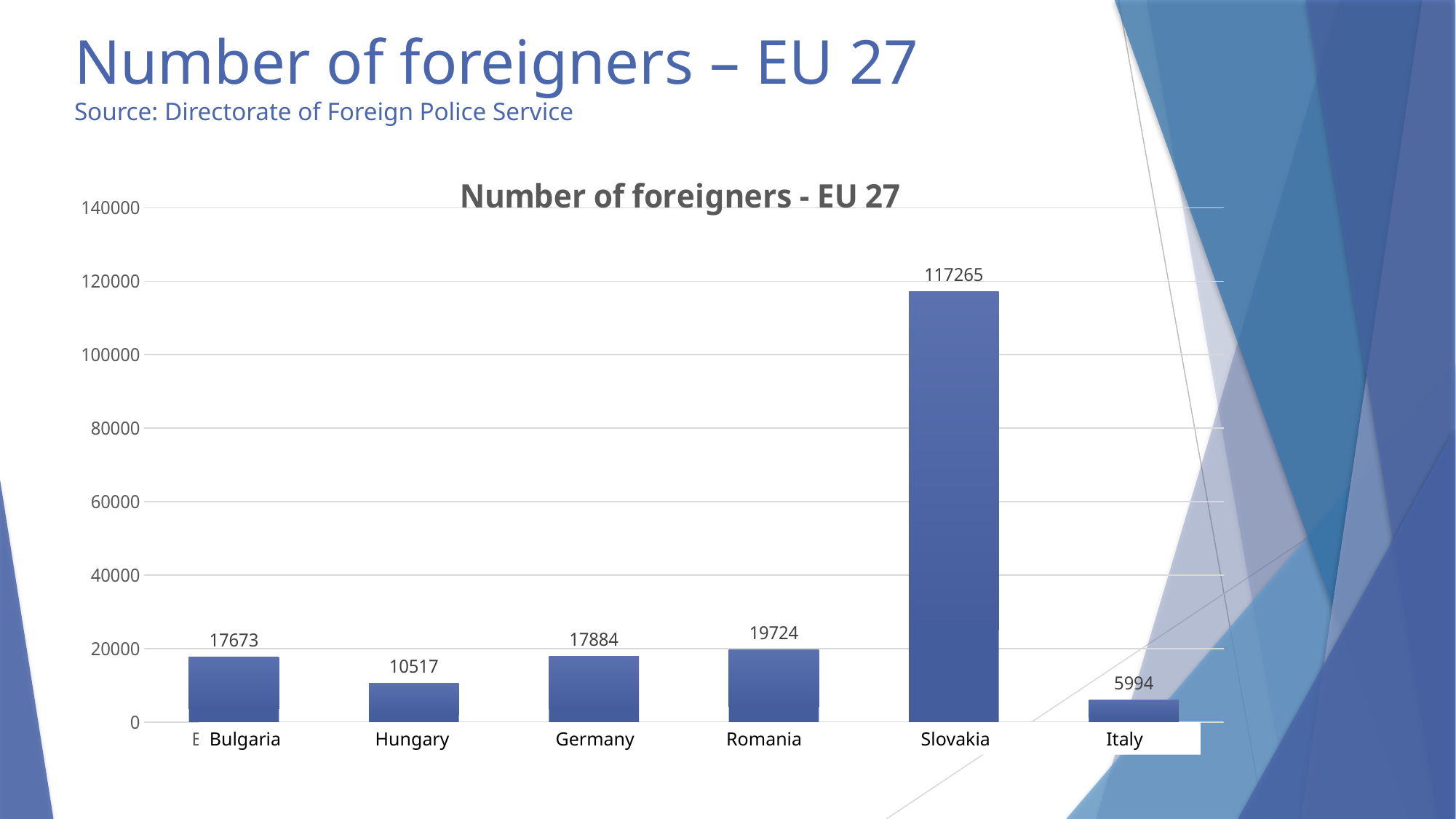
What is the number of foreigners for Hungary? 10517 What is the number of foreigners for Slovakia? 117265 How many countries are shown in the chart? 6 What is the number of foreigners for Romania? 19724 Which is larger, the value for Romania or the value for Hungary? Romania What is the number of foreigners for Italy? 5994 What kind of chart is shown on the slide? Bar chart Which country has the lowest number of foreigners? Italy What is the difference between the values for Germany and Bulgaria? 211 Which country has the highest number of foreigners? Slovakia Is the value for Slovakia greater or less than 100000? greater What is the difference between the values for Slovakia and Romania? 97541